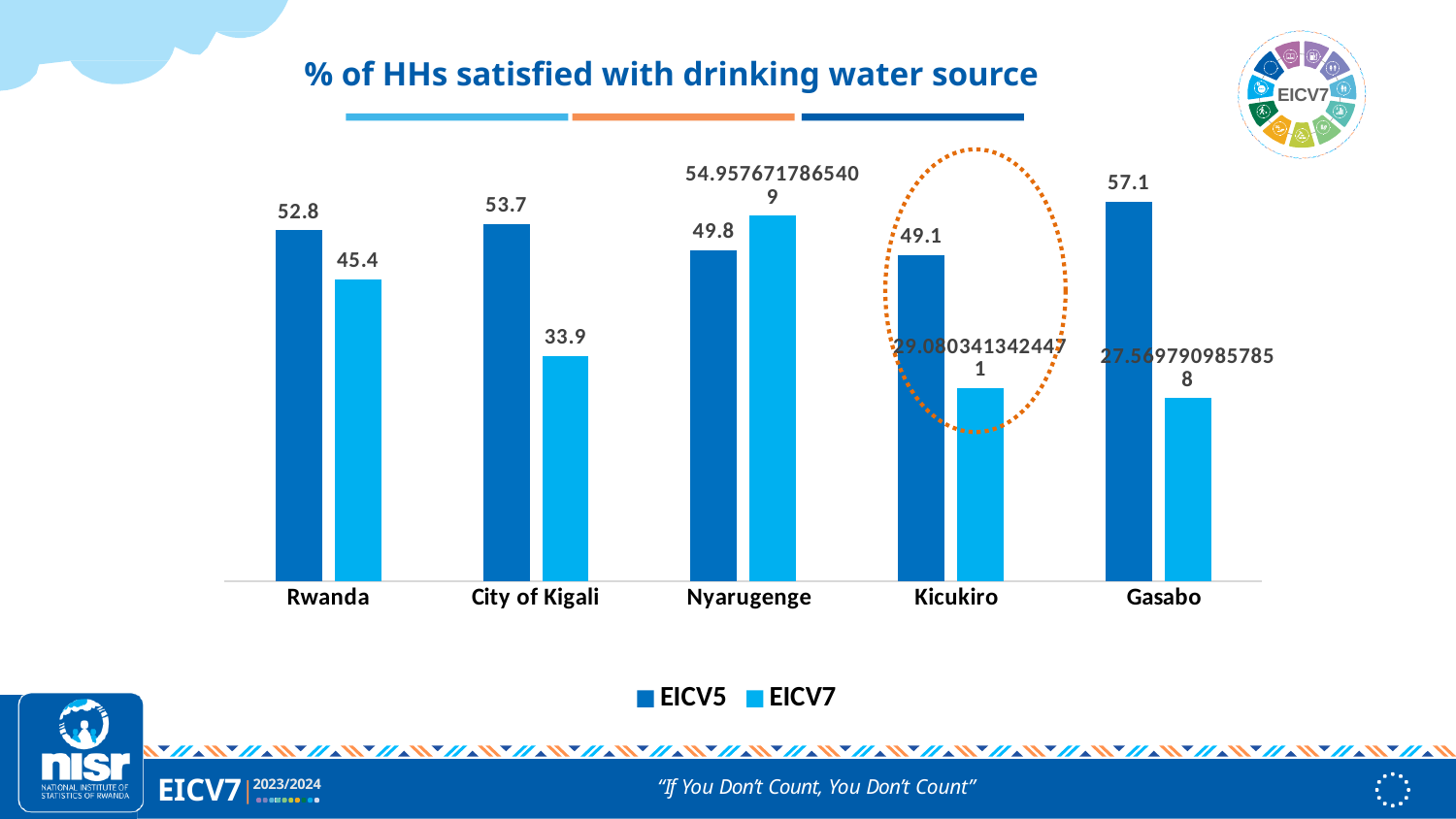
What kind of chart is shown on the slide? Bar chart Which category has the highest EICV5 value? Gasabo For Nyarugenge, which is larger, the EICV5 value or the EICV7 value? EICV7 What is the difference between the EICV5 and EICV7 values for City of Kigali? 19.8 Which category has the lowest EICV5 value? Kicukiro What is the difference between the EICV5 and EICV7 values for Rwanda? 7.4 What is the title of the chart? % of HHs satisfied with drinking water source What is the EICV5 value for Rwanda? 52.8 How many series does the legend list? 2 How many categories are shown on the x axis? 5 What is the EICV5 value for Kicukiro? 49.1 What is the EICV7 value for City of Kigali? 33.9